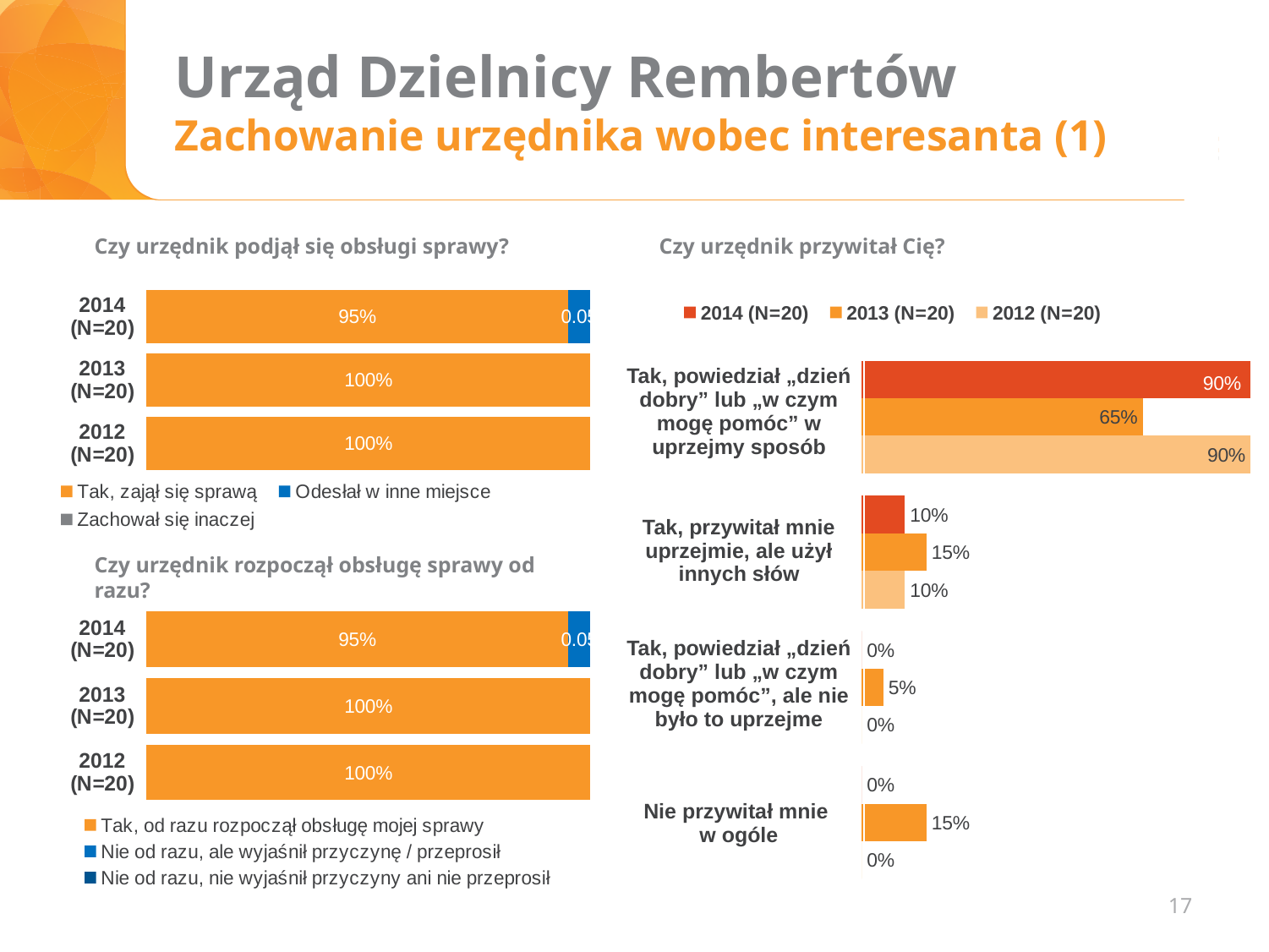
In the chart 'Czy urzędnik przywitał Cię?', what is the value for 2013 (N=20) in the category 'Tak, powiedział „dzień dobry” lub „w czym mogę pomóc” w uprzejmy sposób'? 65% In the chart 'Czy urzędnik przywitał Cię?', what is the value for 2013 (N=20) in the category 'Nie przywitał mnie w ogóle'? 15% In the chart 'Czy urzędnik podjął się obsługi sprawy?', what is the value of 'Tak, zajął się sprawą' for 2014 (N=20)? 95% In the chart 'Czy urzędnik rozpoczął obsługę sprawy od razu?', how many series does the legend list? 3 In the chart 'Czy urzędnik podjął się obsługi sprawy?', what is the value of 'Tak, zajął się sprawą' for 2013 (N=20)? 100% In the chart 'Czy urzędnik przywitał Cię?', what is the value for 2014 (N=20) in the category 'Tak, przywitał mnie uprzejmie, ale użył innych słów'? 10% In the chart 'Czy urzędnik przywitał Cię?', how many response categories are shown? 4 In the chart 'Czy urzędnik rozpoczął obsługę sprawy od razu?', is the 2014 (N=20) value for 'Tak, od razu rozpoczął obsługę mojej sprawy' larger or smaller than the 2012 (N=20) value? smaller In the chart 'Czy urzędnik przywitał Cię?', how many series does the legend list? 3 What type of chart is 'Czy urzędnik rozpoczął obsługę sprawy od razu?'? bar chart In the chart 'Czy urzędnik przywitał Cię?', which year has the lowest value in the category 'Tak, powiedział „dzień dobry” lub „w czym mogę pomóc” w uprzejmy sposób'? 2013 (N=20) In the chart 'Czy urzędnik przywitał Cię?', what is the difference between the 2014 (N=20) and 2013 (N=20) values in the category 'Tak, powiedział „dzień dobry” lub „w czym mogę pomóc” w uprzejmy sposób'? 25%